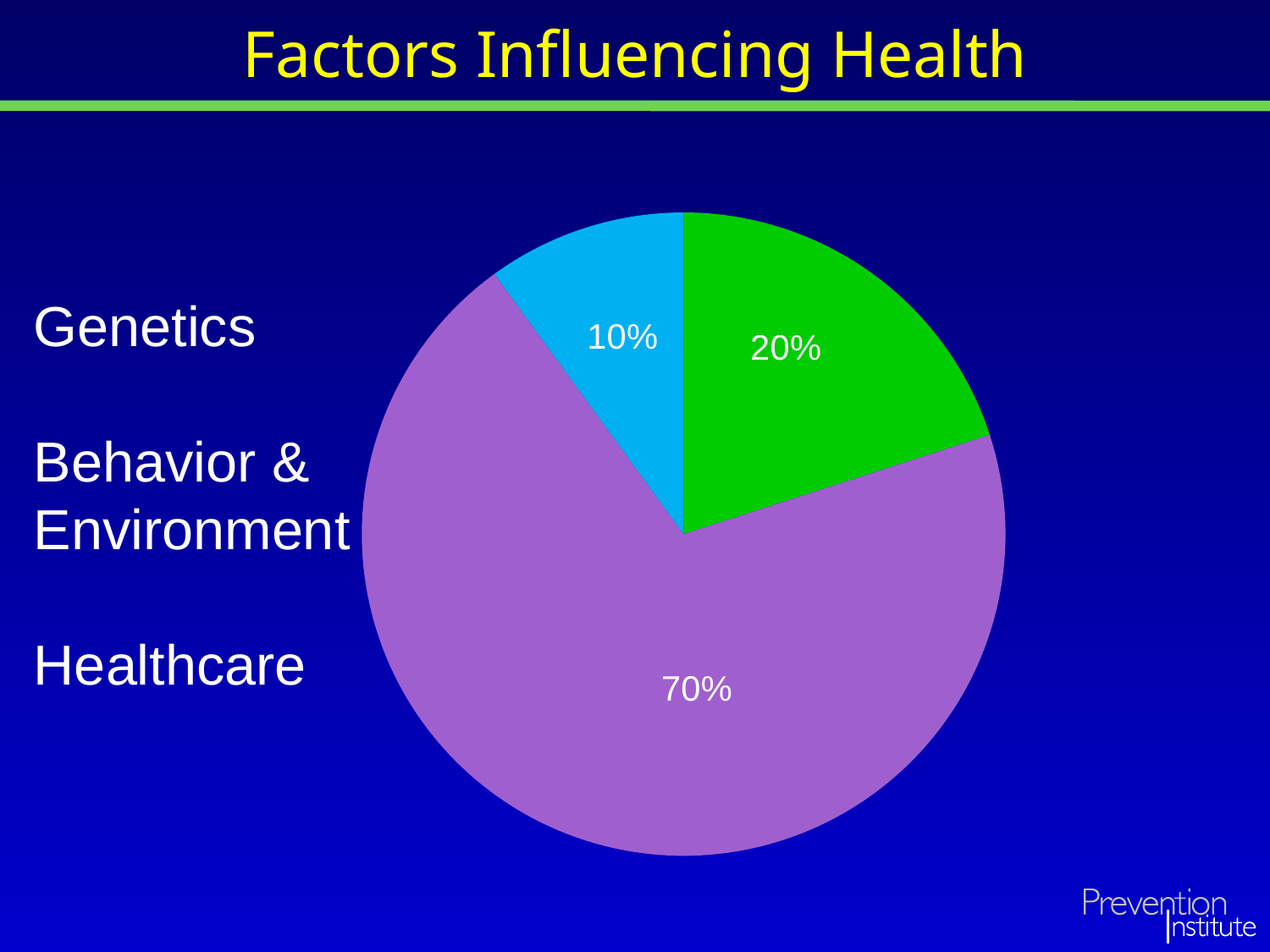
What percentage is shown on the purple slice of the pie chart? 70% What is the value of the largest slice of the pie chart? 70% How many slices does the pie chart have? 3 What factors are listed as text to the left of the pie chart? Genetics, Behavior & Environment, Healthcare What share of the pie does the purple slice represent? 70% What percentage is shown on the green slice of the pie chart? 20% What is the value of the smallest slice of the pie chart? 10% What percentage is shown on the blue slice of the pie chart? 10% What kind of chart is shown on the slide? pie chart What is the title of the slide containing the pie chart? Factors Influencing Health Which slice is larger, the green slice or the blue slice? green What is the difference in percentage points between the purple slice and the green slice? 50